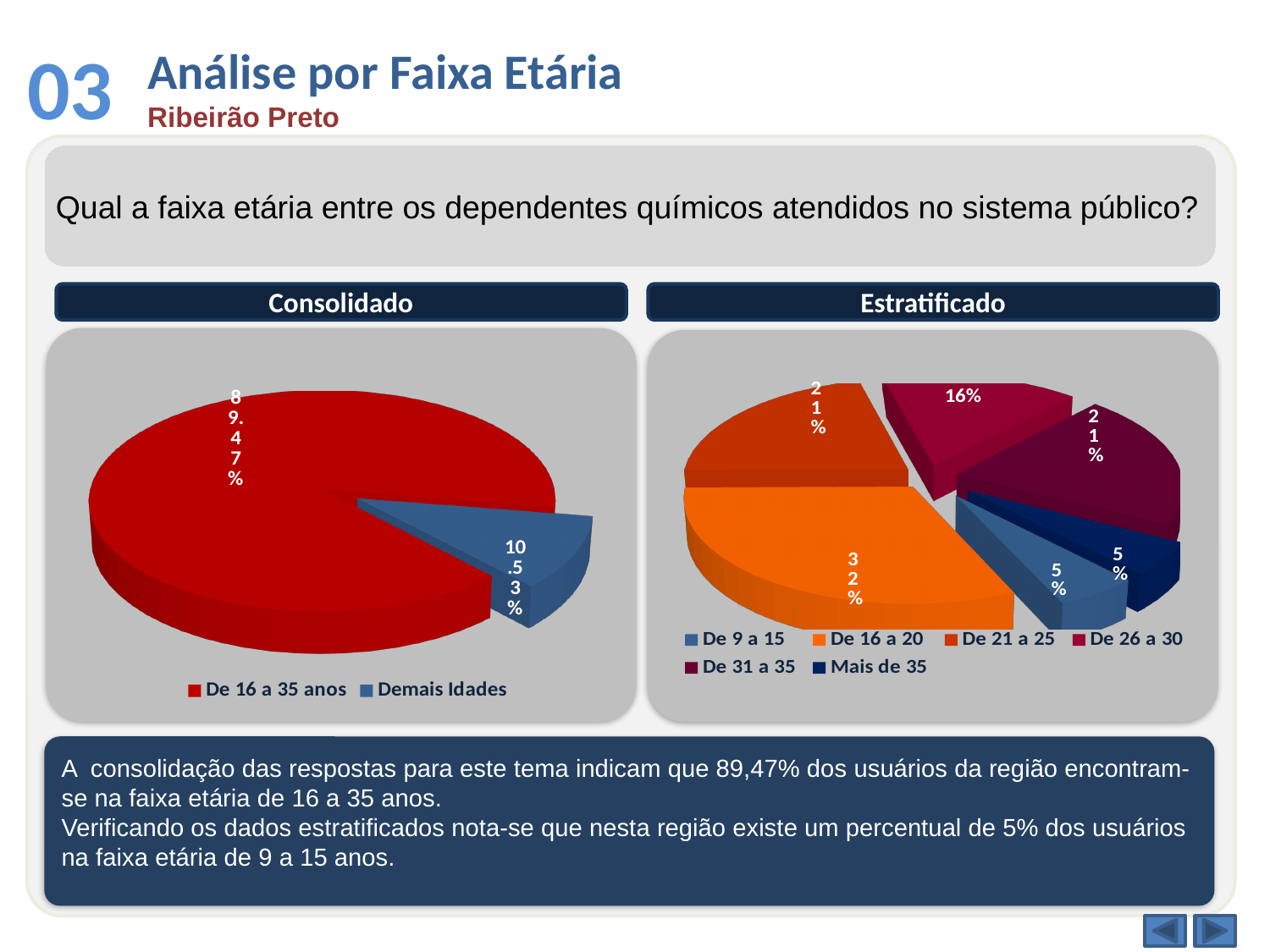
In the Consolidado chart, what percentage is shown for Demais Idades? 10.53% In the Estratificado chart, what is the difference between the shares of De 16 a 20 and De 26 a 30? 16% In the Estratificado chart, what percentage is shown for De 16 a 20? 32% In the Consolidado chart, which category has the largest slice? De 16 a 35 anos In the Estratificado chart, what percentage is shown for De 9 a 15? 5% In the Consolidado chart, what percentage is shown for De 16 a 35 anos? 89.47% In the Estratificado chart, which is larger, the share for De 21 a 25 or the share for Mais de 35? De 21 a 25 In the Estratificado chart, which category has the largest share? De 16 a 20 What type of chart is the Estratificado chart? Pie chart In the Consolidado chart, how many categories does the legend list? 2 In the Estratificado chart, how many categories does the legend list? 6 In the Estratificado chart, what percentage is shown for De 26 a 30? 16%